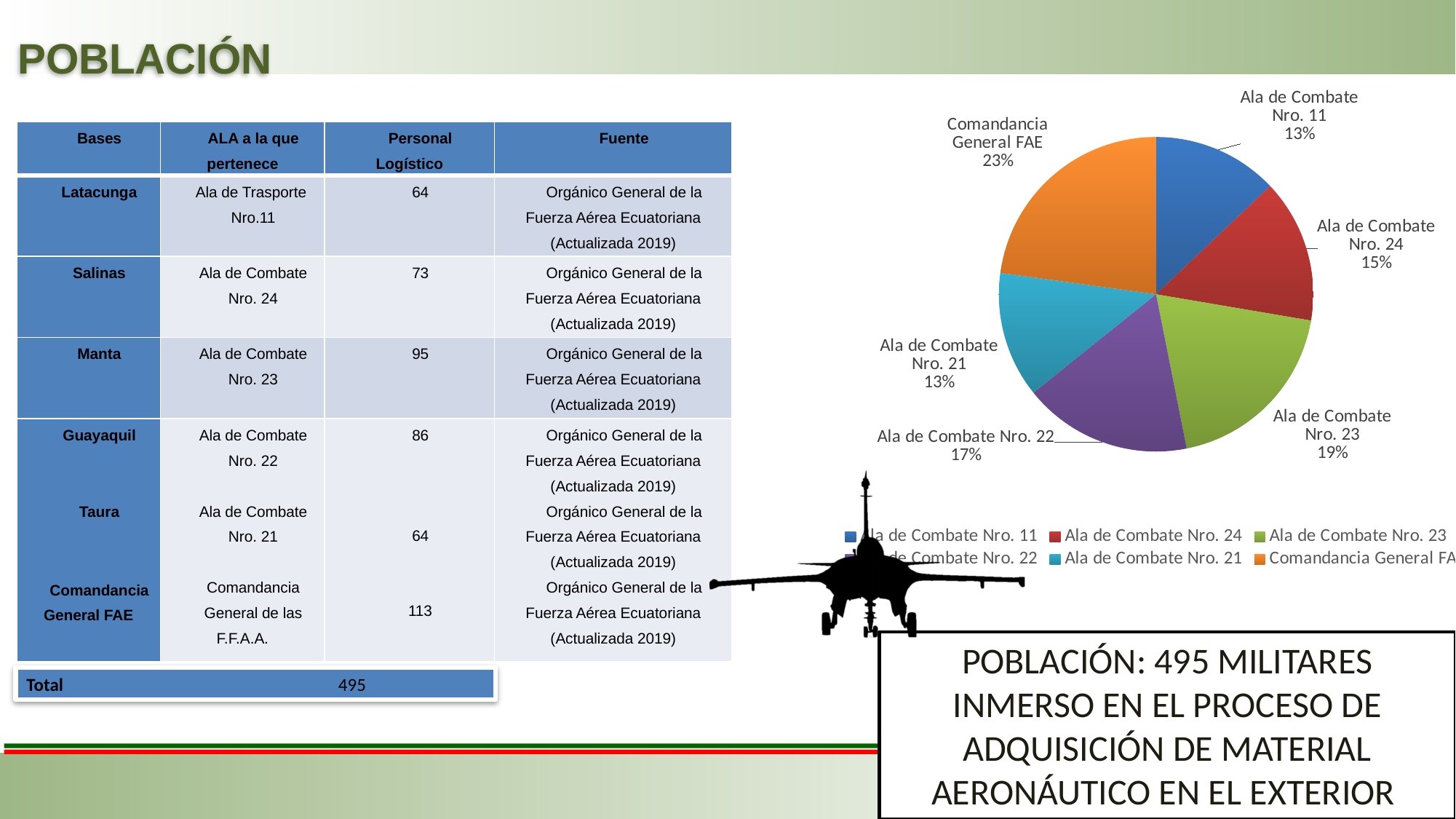
What colour is the Comandancia General FAE slice in the pie chart? orange What is the difference in percentage points between the Comandancia General FAE slice and the Ala de Combate Nro. 21 slice? 10 How many slices does the pie chart have? 6 What percentage of the pie chart does Comandancia General FAE represent? 23% Which slice of the pie chart is the largest? Comandancia General FAE What percentage of the pie chart does Ala de Combate Nro. 11 represent? 13% What is the difference in percentage points between the Ala de Combate Nro. 23 slice and the Ala de Combate Nro. 24 slice? 4 What type of chart is shown on the slide? pie chart Which slice is larger in the pie chart, Ala de Combate Nro. 23 or Ala de Combate Nro. 22? Ala de Combate Nro. 23 What percentage of the pie chart does Ala de Combate Nro. 22 represent? 17%